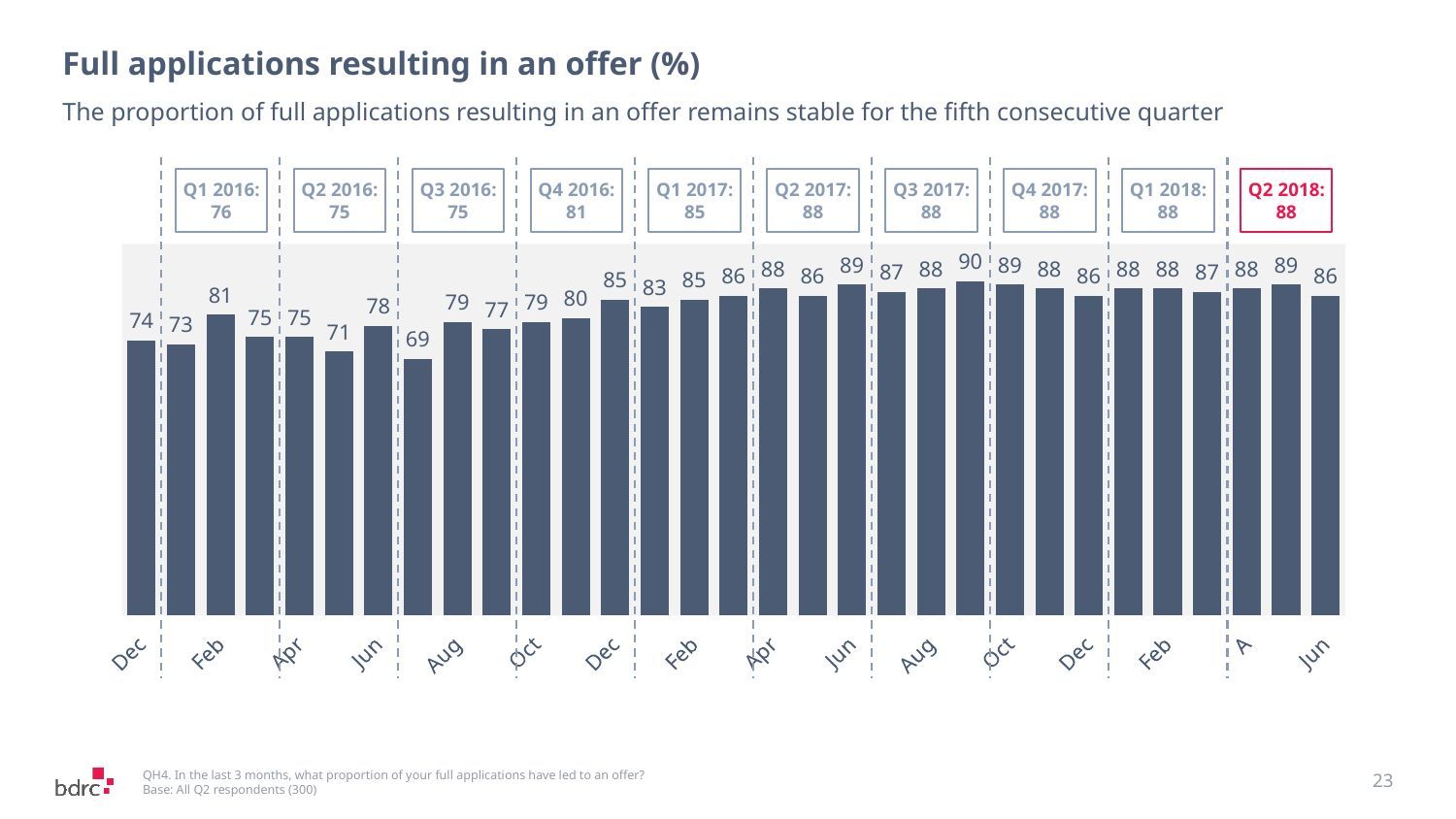
What is the value of the first bar (Dec) on the left of the chart? 74 What is the highest value shown on any bar in the chart? 90 What is the quarterly value shown for Q4 2016? 81 Do the bar values generally rise or fall from left to right across the chart? rise What type of chart is shown on the slide? bar chart How many quarterly summary boxes are shown above the chart? 10 What is the quarterly value shown for Q2 2018? 88 What is the lowest value shown on any bar in the chart? 69 What is the difference between the quarterly values for Q2 2018 and Q1 2016? 12 What is the quarterly value shown for Q1 2016? 76 Which quarter has the larger value, Q4 2016 or Q1 2017? Q1 2017 What is the value of the last bar (Jun) on the right of the chart? 86